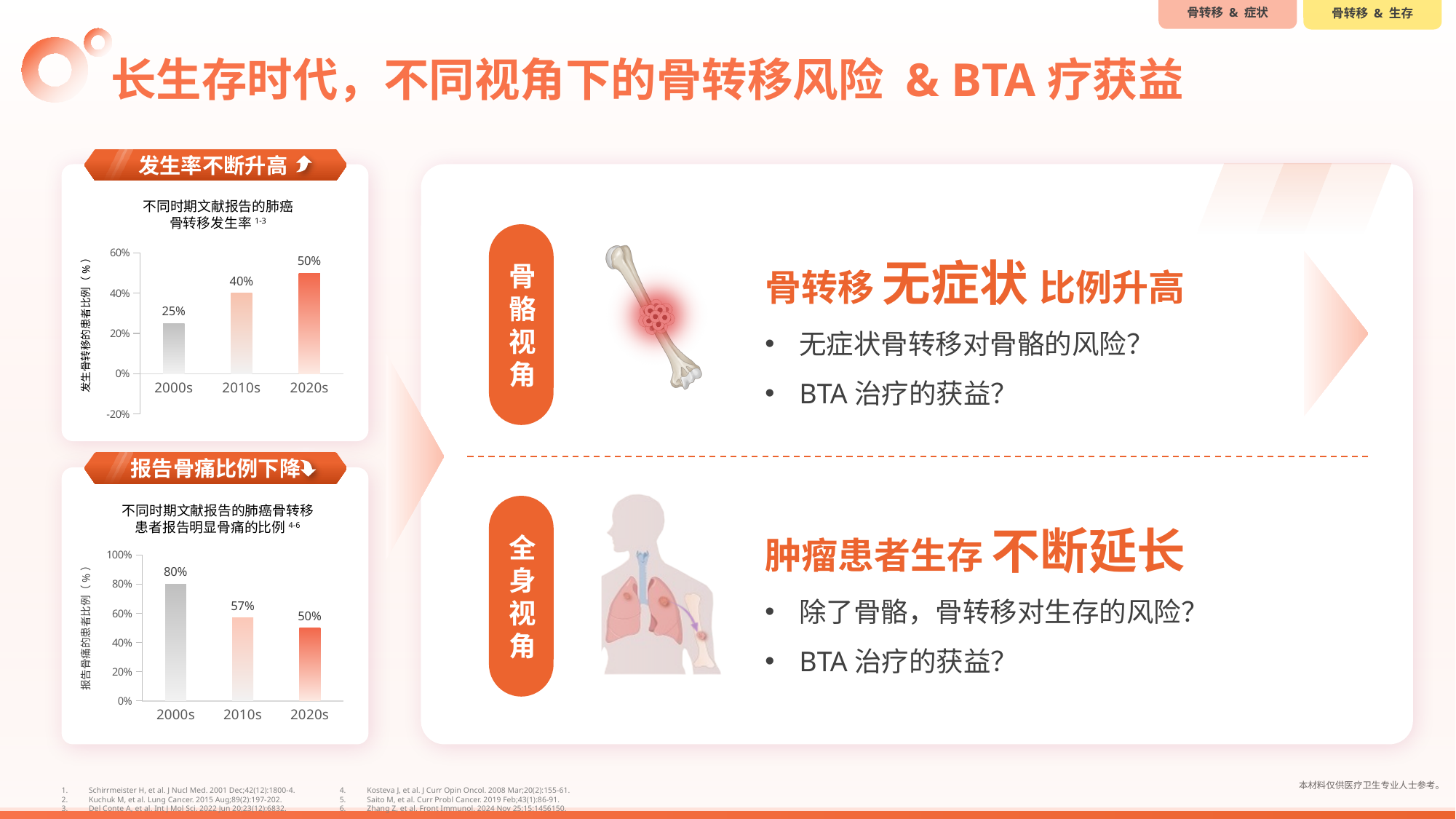
In the bottom chart (不同时期文献报告的肺癌骨转移患者报告明显骨痛的比例), which period has the lowest value? 2020s In the bottom chart (不同时期文献报告的肺癌骨转移患者报告明显骨痛的比例), what is the value for 2010s? 57% What kind of chart is the bottom chart (不同时期文献报告的肺癌骨转移患者报告明显骨痛的比例)? bar chart In the bottom chart (不同时期文献报告的肺癌骨转移患者报告明显骨痛的比例), what is the difference between the 2000s and 2010s values? 23% In the top chart (不同时期文献报告的肺癌骨转移发生率), which period has the highest value? 2020s In the top chart (不同时期文献报告的肺癌骨转移发生率), do the values rise or fall from 2000s to 2020s? rise How many periods (categories) are shown on the x axis of the top chart (不同时期文献报告的肺癌骨转移发生率)? 3 In the top chart (不同时期文献报告的肺癌骨转移发生率), what is the value for 2000s? 25% In the top chart (不同时期文献报告的肺癌骨转移发生率), what is the difference between the 2020s and 2000s values? 25% In the bottom chart (不同时期文献报告的肺癌骨转移患者报告明显骨痛的比例), do the values rise or fall from 2000s to 2020s? fall In the bottom chart (不同时期文献报告的肺癌骨转移患者报告明显骨痛的比例), what is the value for 2000s? 80% In the top chart (不同时期文献报告的肺癌骨转移发生率), what is the value for 2020s? 50%